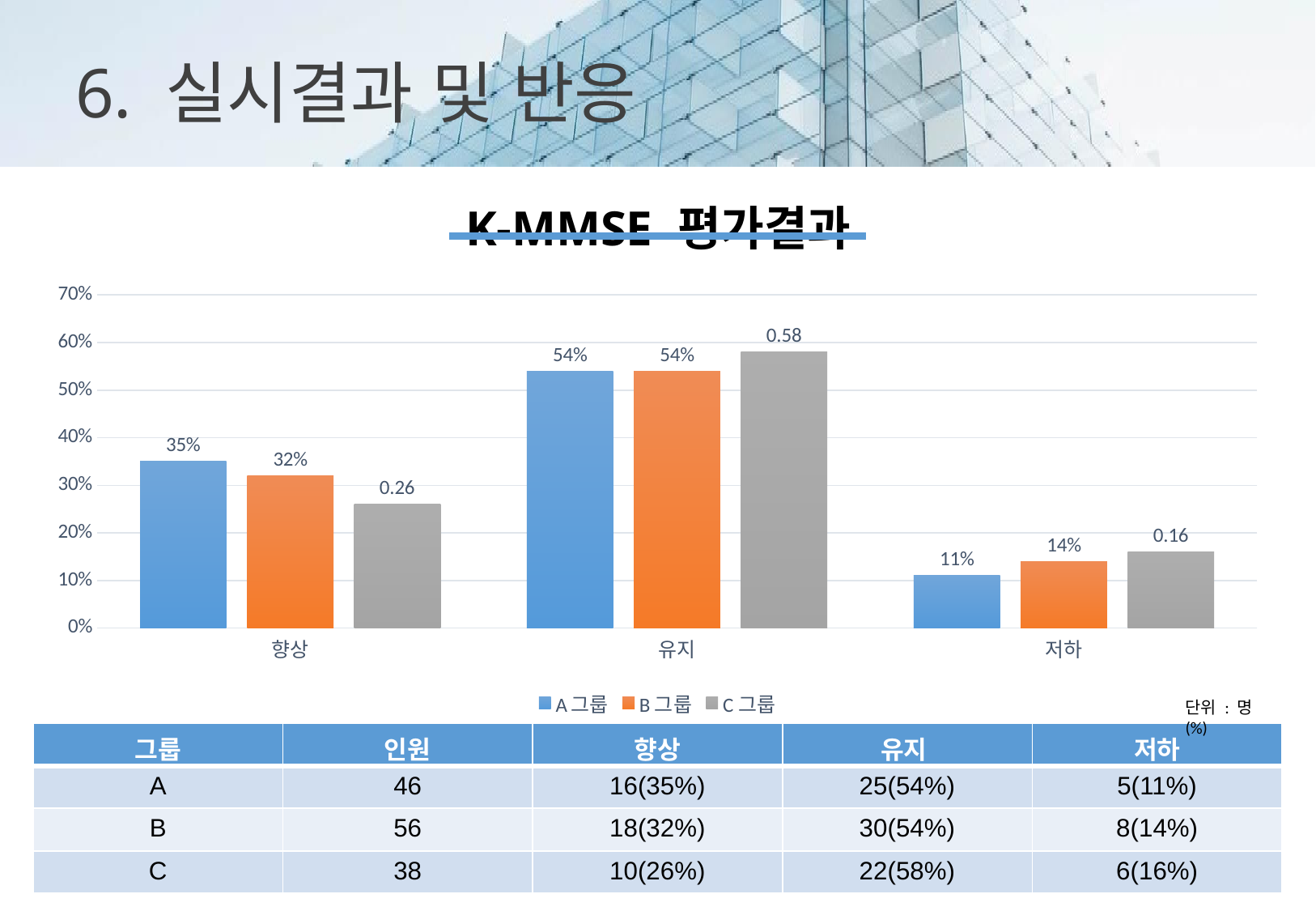
What is the data label shown for C 그룹 in the 향상 category? 0.26 What colour represents B 그룹 in the chart? orange What is the value for B 그룹 in the 저하 category? 14% What is the data label shown for C 그룹 in the 유지 category? 0.58 What type of chart is shown on the slide? bar chart How many series does the legend list? 3 How many categories are shown on the x axis? 3 What is the value for A 그룹 in the 향상 category? 35% Which group has the lowest value in the 저하 category? A 그룹 Which is larger: B 그룹 in 저하 or A 그룹 in 저하? B 그룹 in 저하 What is the difference between A 그룹 and B 그룹 in the 향상 category? 3% Which group has the highest value in the 유지 category? C 그룹